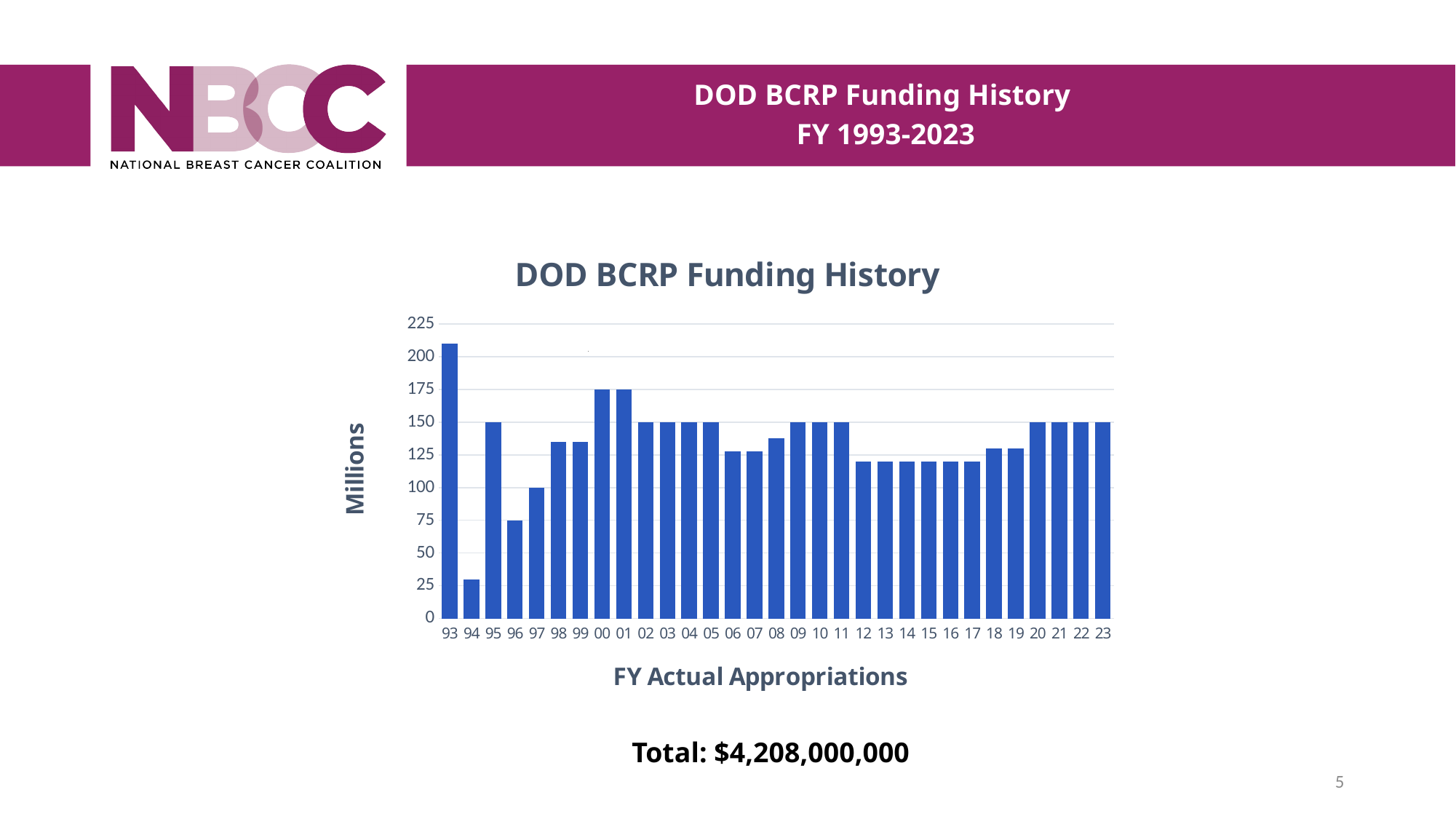
What is the title of the chart? DOD BCRP Funding History How many fiscal years are plotted on the x axis? 31 What is the funding value (in millions) for fiscal year 00? 175 What is the funding value (in millions) for fiscal year 96? 75 Which fiscal year has the highest funding value? 93 Is the value for fiscal year 12 greater or less than 125? less Which fiscal year has the lowest funding value? 94 What is the difference (in millions) between the values for fiscal years 00 and 97? 75 Is the value for fiscal year 93 greater or less than 200? greater What is the label on the vertical axis of the chart? Millions What kind of chart is shown on the slide? bar chart What is the funding value (in millions) for fiscal year 97? 100